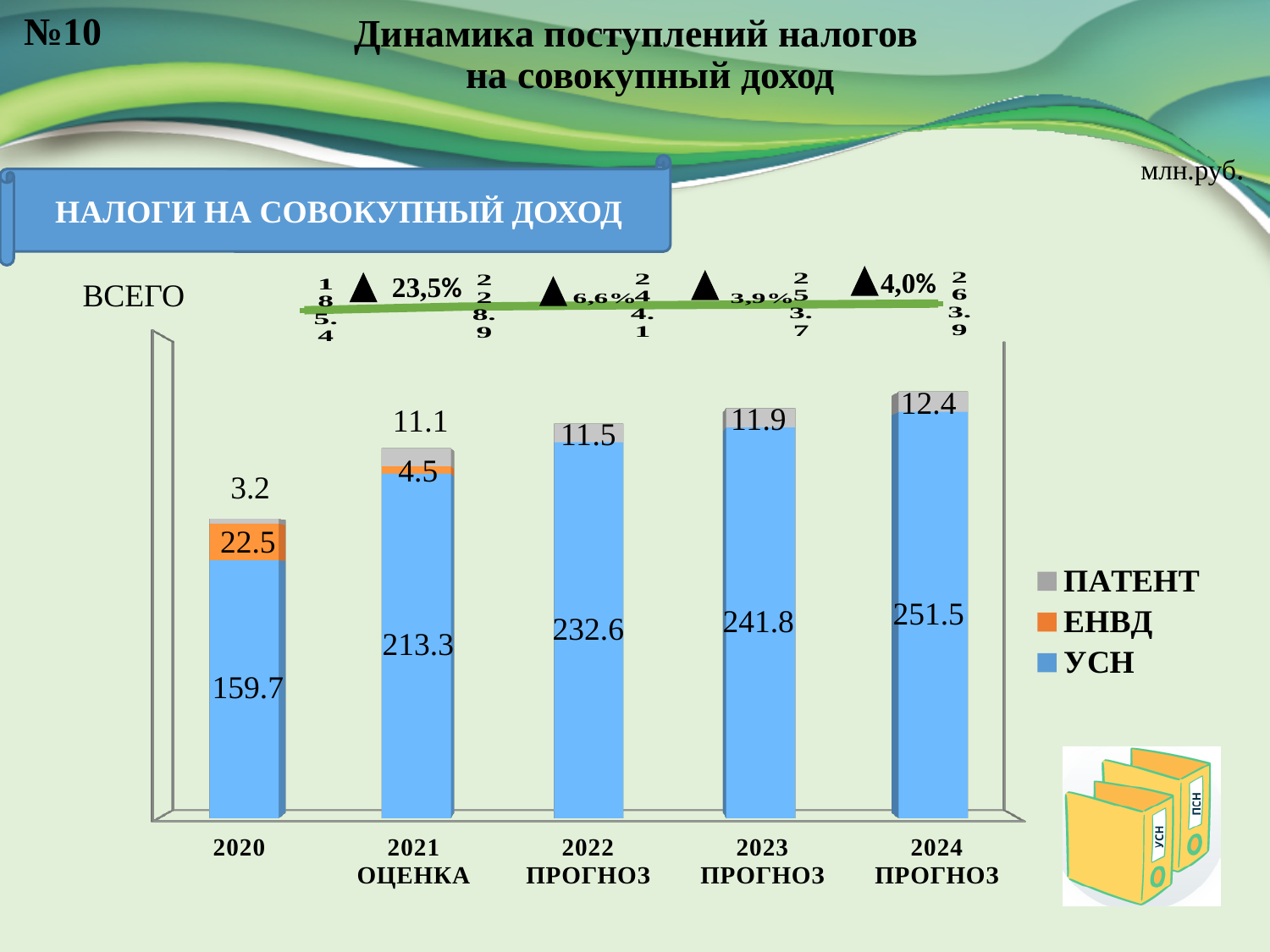
How many series does the legend list? 3 Which year has the lowest УСН value? 2020 How many years (categories) are shown on the x axis? 5 Which is larger, the ЕНВД value for 2020 or the ЕНВД value for 2021 ОЦЕНКА? 2020 What kind of chart is shown on the slide? Stacked bar chart What is the УСН value for 2020? 159.7 Which year has the highest УСН value? 2024 ПРОГНОЗ What is the ЕНВД value for 2021 ОЦЕНКА? 4.5 What is the total of the stacked bar for 2020? 185.4 What is the ПАТЕНТ value for 2024 ПРОГНОЗ? 12.4 What is the difference between the УСН values for 2024 ПРОГНОЗ and 2023 ПРОГНОЗ? 9.7 What is the total of the stacked bar for 2022 ПРОГНОЗ? 244.1